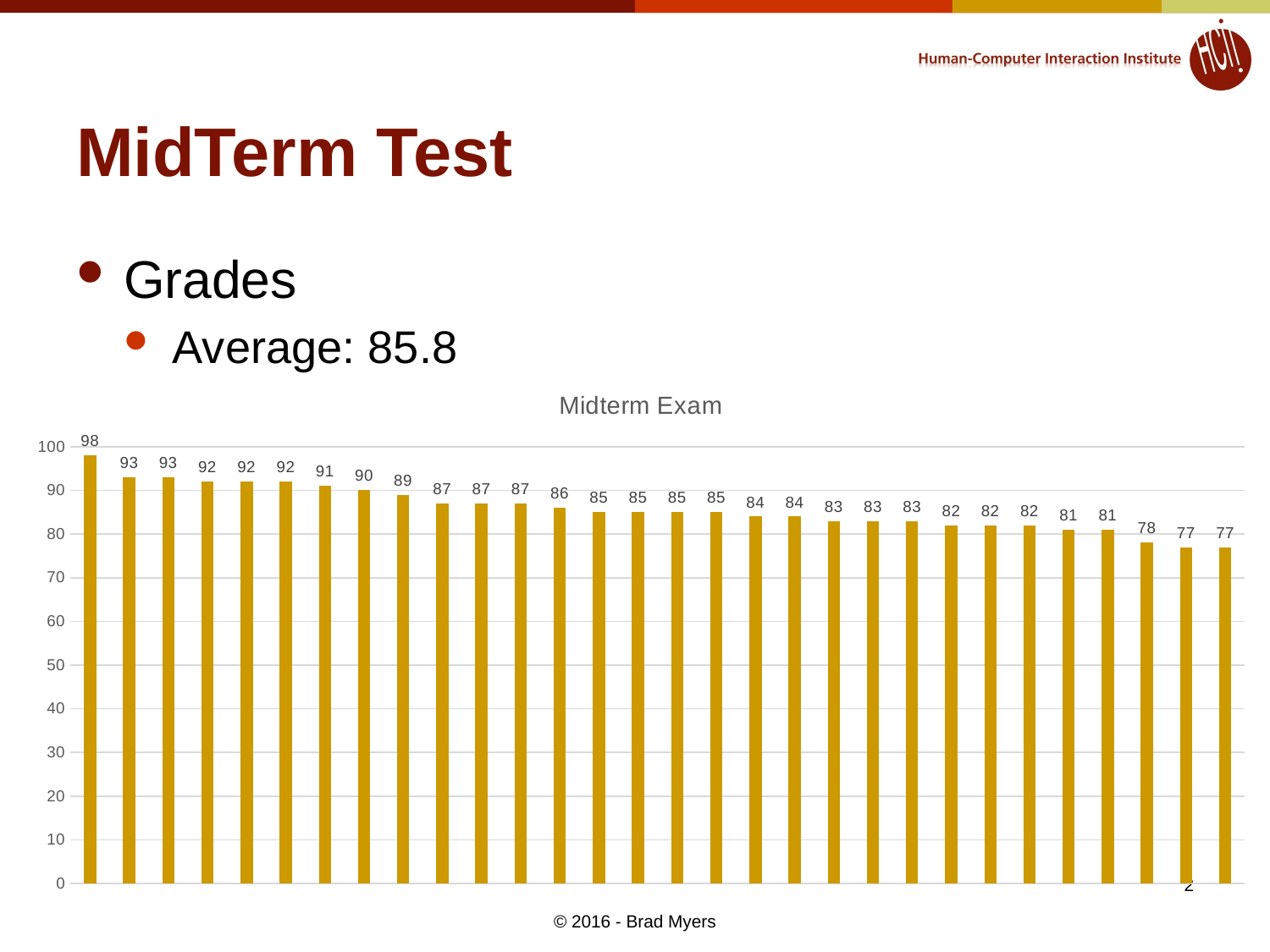
What is the value of the last (rightmost) bar in the chart? 77 What is the lowest value shown in the chart? 77 What is the title of the chart? Midterm Exam Which is larger, the value of the leftmost bar or the value of the rightmost bar? the leftmost bar What is the value of the first (leftmost) bar in the chart? 98 Is the value of the leftmost bar greater or less than 90? greater What is the highest value shown in the chart? 98 What kind of chart is shown on the slide? bar chart How many bars are plotted in the chart? 30 How many bars in the chart have a value of 85? 4 Do the values rise or fall from left to right along the x axis? fall What is the difference between the highest and lowest values in the chart? 21